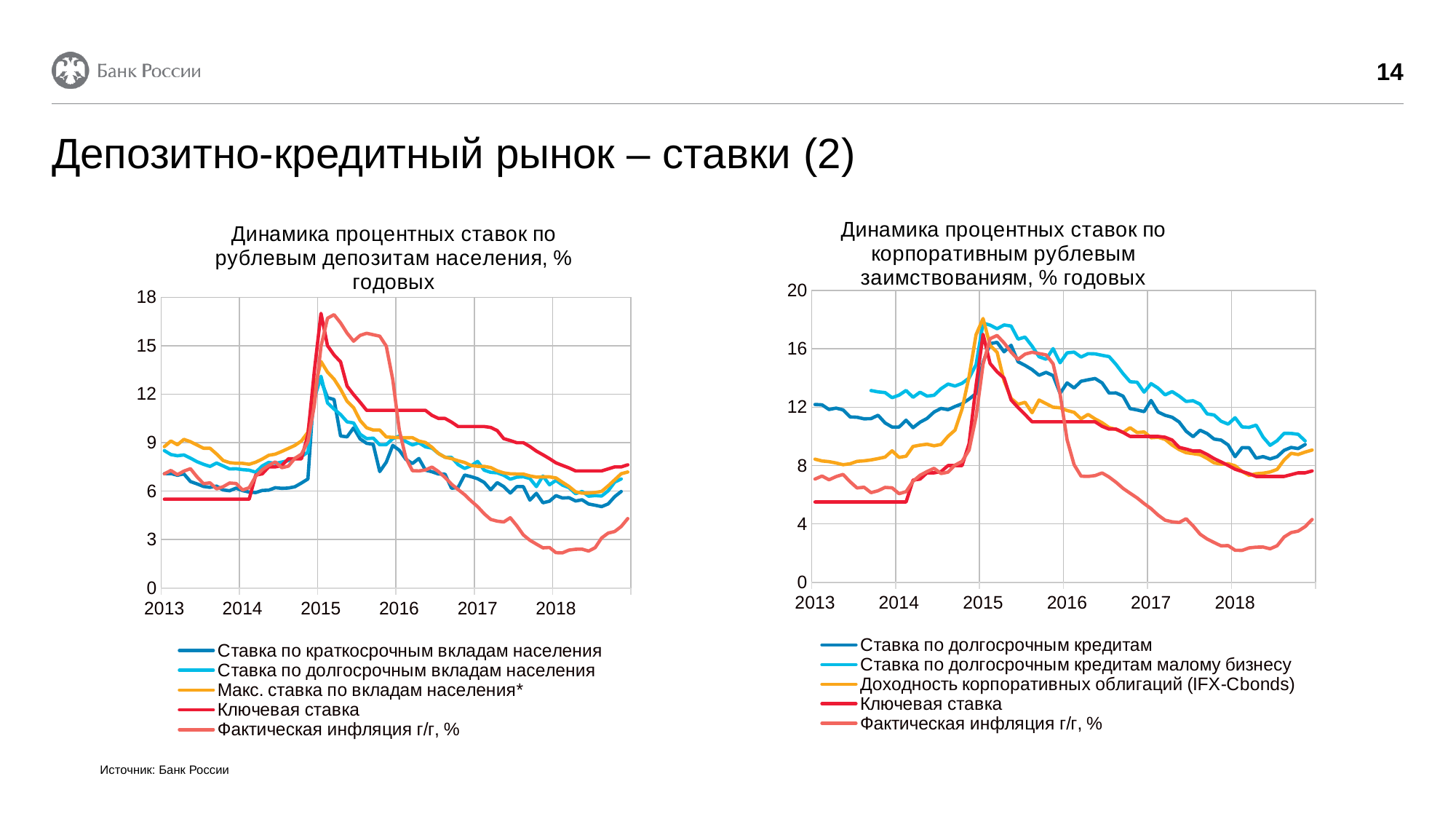
How many series does the legend of the right chart, 'Динамика процентных ставок по корпоративным рублевым заимствованиям, % годовых', list? 5 In the right chart, 'Динамика процентных ставок по корпоративным рублевым заимствованиям, % годовых', is the value of 'Ключевая ставка' at the start of 2013 greater or less than 8? less In the left chart, 'Динамика процентных ставок по рублевым депозитам населения, % годовых', does 'Фактическая инфляция г/г, %' rise or fall from the start of 2015 to the start of 2018? fall What type of chart is the left chart, 'Динамика процентных ставок по рублевым депозитам населения, % годовых'? Line chart In the left chart, 'Динамика процентных ставок по рублевым депозитам населения, % годовых', is the peak value of 'Ключевая ставка' around the start of 2015 greater or less than 15? greater In the left chart, 'Динамика процентных ставок по рублевым депозитам населения, % годовых', is the value of 'Ключевая ставка' at the start of 2013 greater or less than 6? less How many series does the legend of the left chart, 'Динамика процентных ставок по рублевым депозитам населения, % годовых', list? 5 What is the title of the right chart on the slide? Динамика процентных ставок по корпоративным рублевым заимствованиям, % годовых In the right chart, 'Динамика процентных ставок по корпоративным рублевым заимствованиям, % годовых', at the start of 2013, which is larger: 'Ставка по долгосрочным кредитам' or 'Ключевая ставка'? Ставка по долгосрочным кредитам In the right chart, 'Динамика процентных ставок по корпоративным рублевым заимствованиям, % годовых', does 'Ключевая ставка' rise or fall from the start of 2015 to the start of 2018? fall